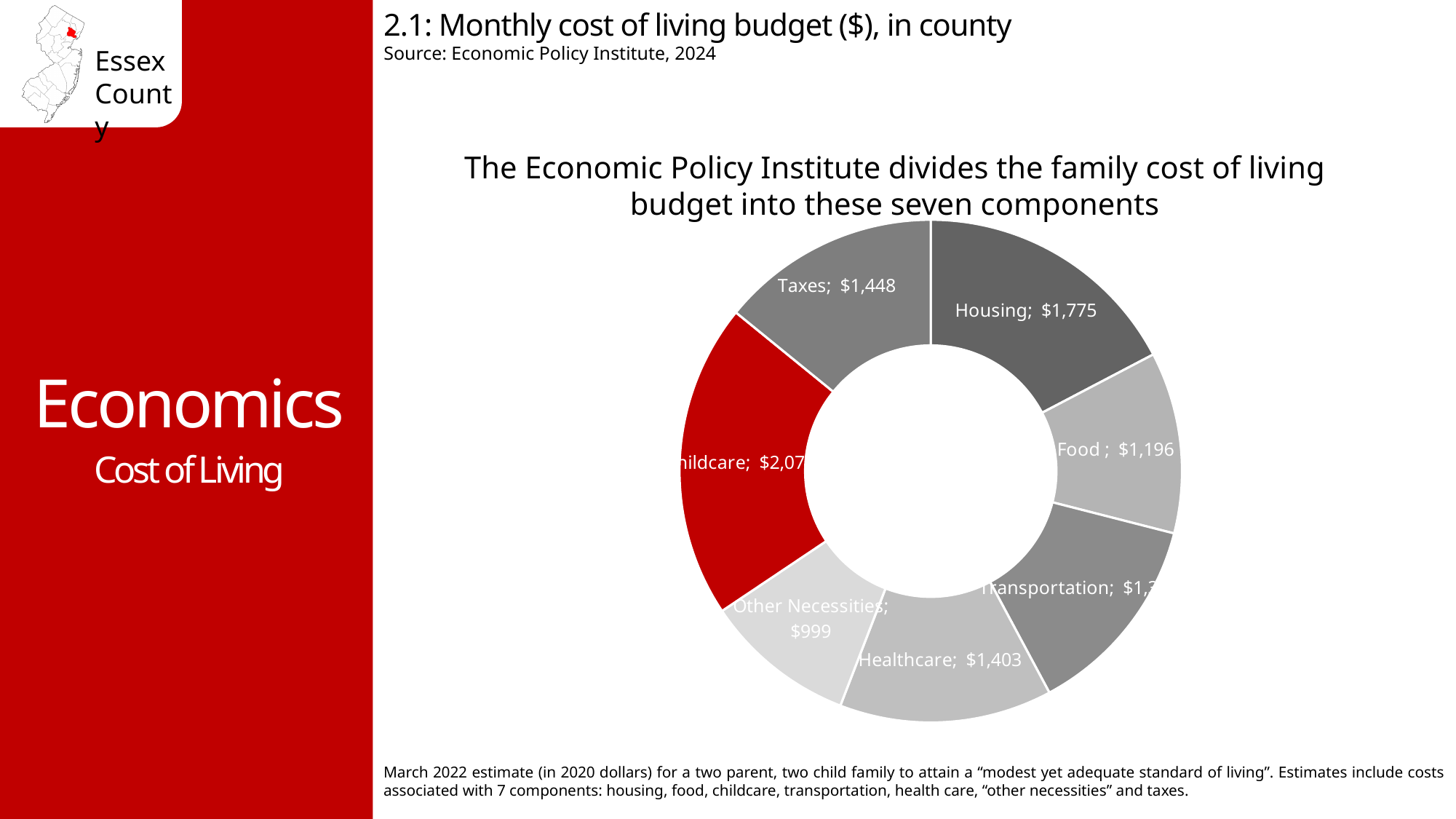
What is the monthly cost for Food? $1,196 What is the difference between the Housing and Taxes monthly costs? $327 Which component's slice is coloured red? Childcare How many components (slices) does the chart show? 7 Which is larger, the monthly cost for Healthcare or for Food? Healthcare What is the monthly cost for Taxes? $1,448 What is the monthly cost for Other Necessities? $999 Which component has the smallest monthly cost? Other Necessities What type of chart is shown on the slide? Doughnut (pie) chart What is the monthly cost for Housing? $1,775 What is the monthly cost for Healthcare? $1,403 Which component has the largest monthly cost? Childcare